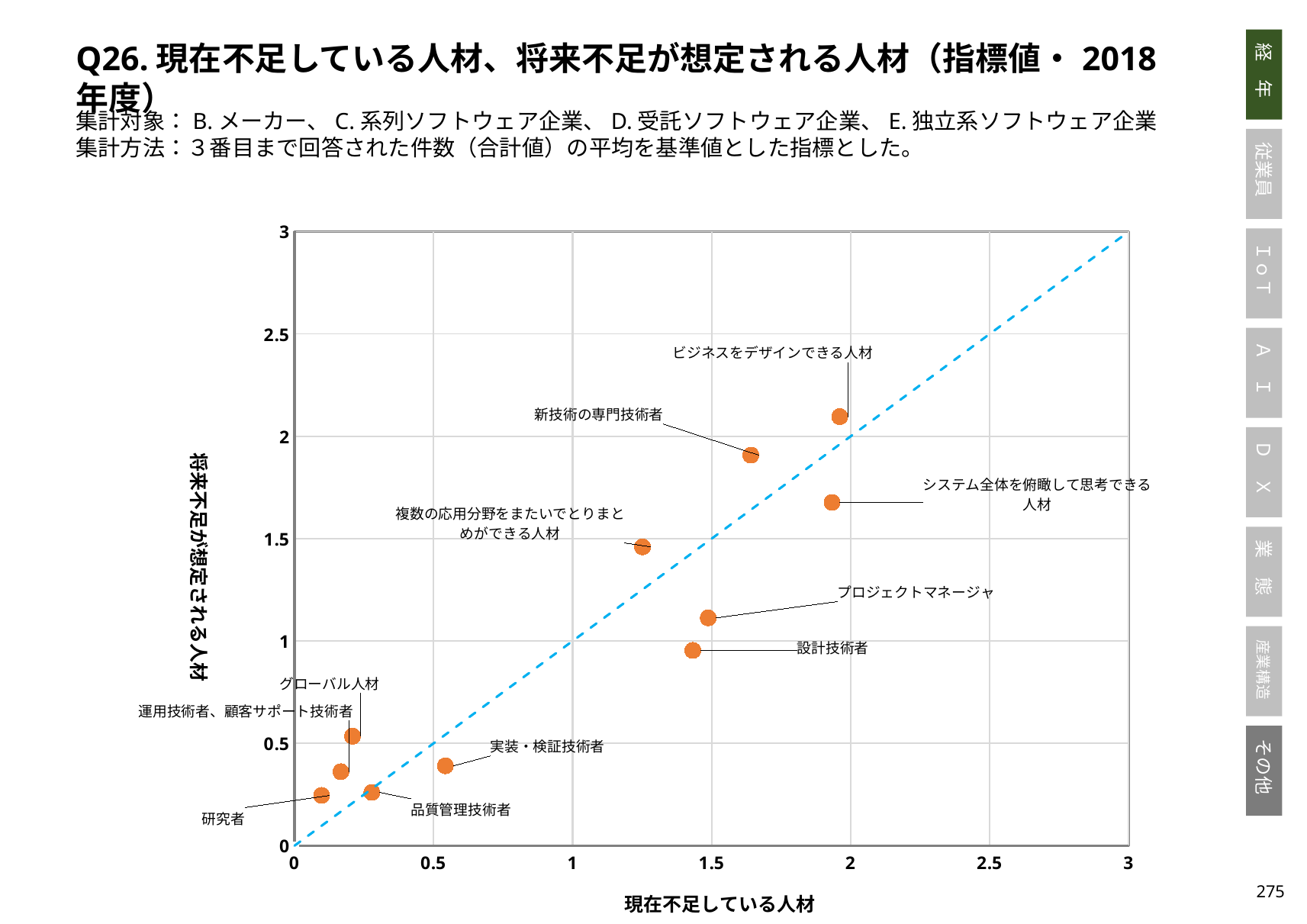
What is the title of the horizontal axis? 現在不足している人材 Which labeled point has the highest value on the vertical axis (将来不足が想定される人材)? ビジネスをデザインできる人材 Is the horizontal-axis value for ビジネスをデザインできる人材 greater or less than 1.5? greater Do the plotted points generally rise or fall as the horizontal-axis value increases? rise Is the vertical-axis value for 設計技術者 greater or less than 1? less Is the vertical-axis value for 新技術の専門技術者 greater or less than 1.5? greater How many labeled data points are plotted on the chart? 11 What kind of chart is shown on the slide? scatter chart Which labeled point has the lowest value on the horizontal axis (現在不足している人材)? 研究者 Which has the higher horizontal-axis value, 実装・検証技術者 or グローバル人材? 実装・検証技術者 Which has the higher vertical-axis value, ビジネスをデザインできる人材 or システム全体を俯瞰して思考できる人材? ビジネスをデザインできる人材